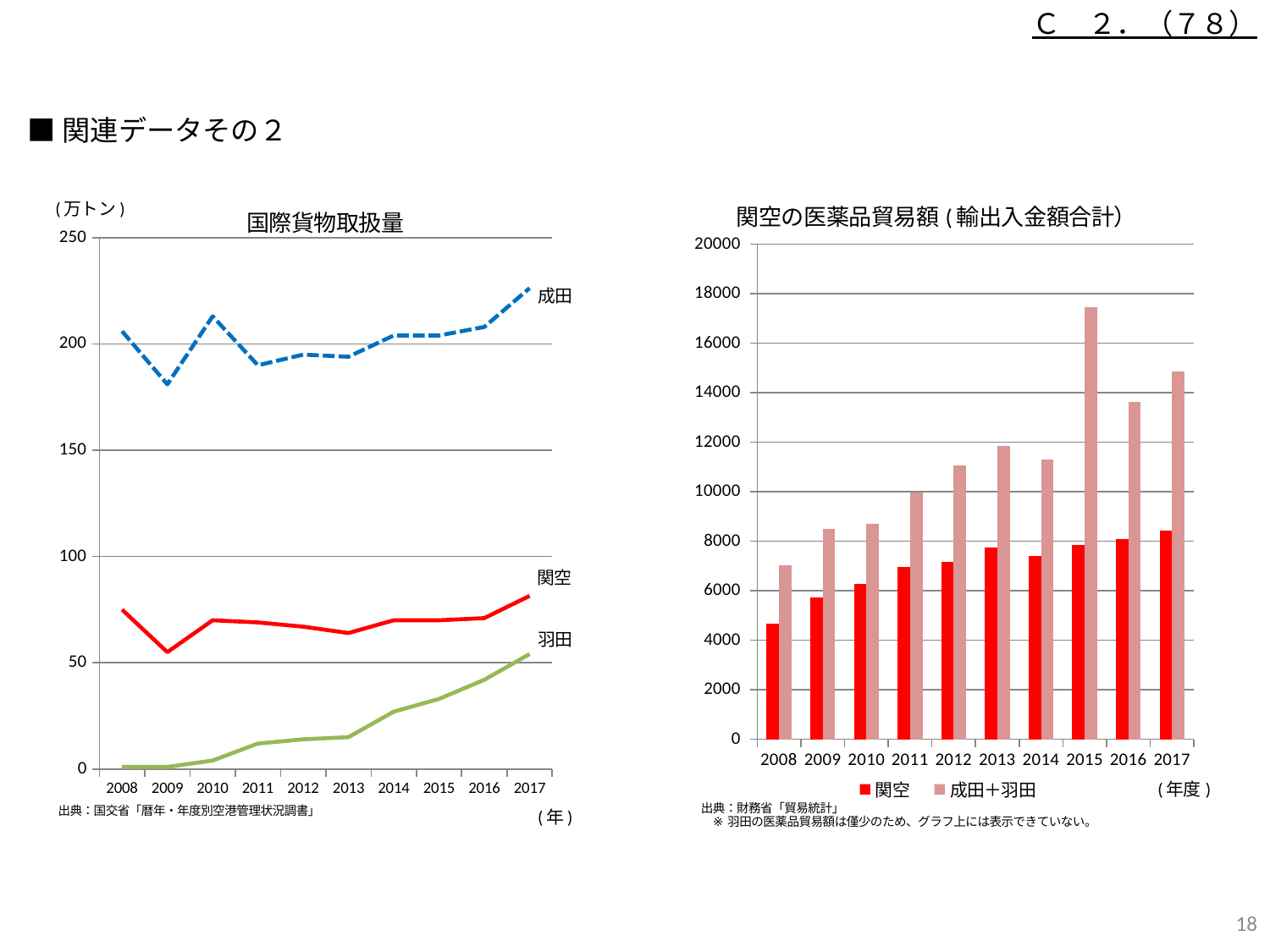
In the left chart 国際貨物取扱量, which series has the lowest values across all years? 羽田 In the right chart 関空の医薬品貿易額, how many series does the legend list? 2 In the left chart 国際貨物取扱量, is the value for 成田 in 2009 greater or less than 200? less What kind of chart is the right chart titled 関空の医薬品貿易額(輸出入金額合計)? bar chart In the right chart 関空の医薬品貿易額, in which year is the 関空 bar lowest? 2008 In the right chart 関空の医薬品貿易額, how many years are shown on the x axis? 10 What kind of chart is the left chart titled 国際貨物取扱量? line chart In the left chart 国際貨物取扱量, does the 羽田 series rise or fall from 2008 to 2017? rise In the left chart 国際貨物取扱量, which series has the highest values across all years? 成田 In the right chart 関空の医薬品貿易額, in which year is the 成田＋羽田 bar highest? 2015 In the right chart 関空の医薬品貿易額, is the value for 関空 in 2017 greater or less than 8000? greater In the left chart 国際貨物取扱量, how many series are plotted? 3